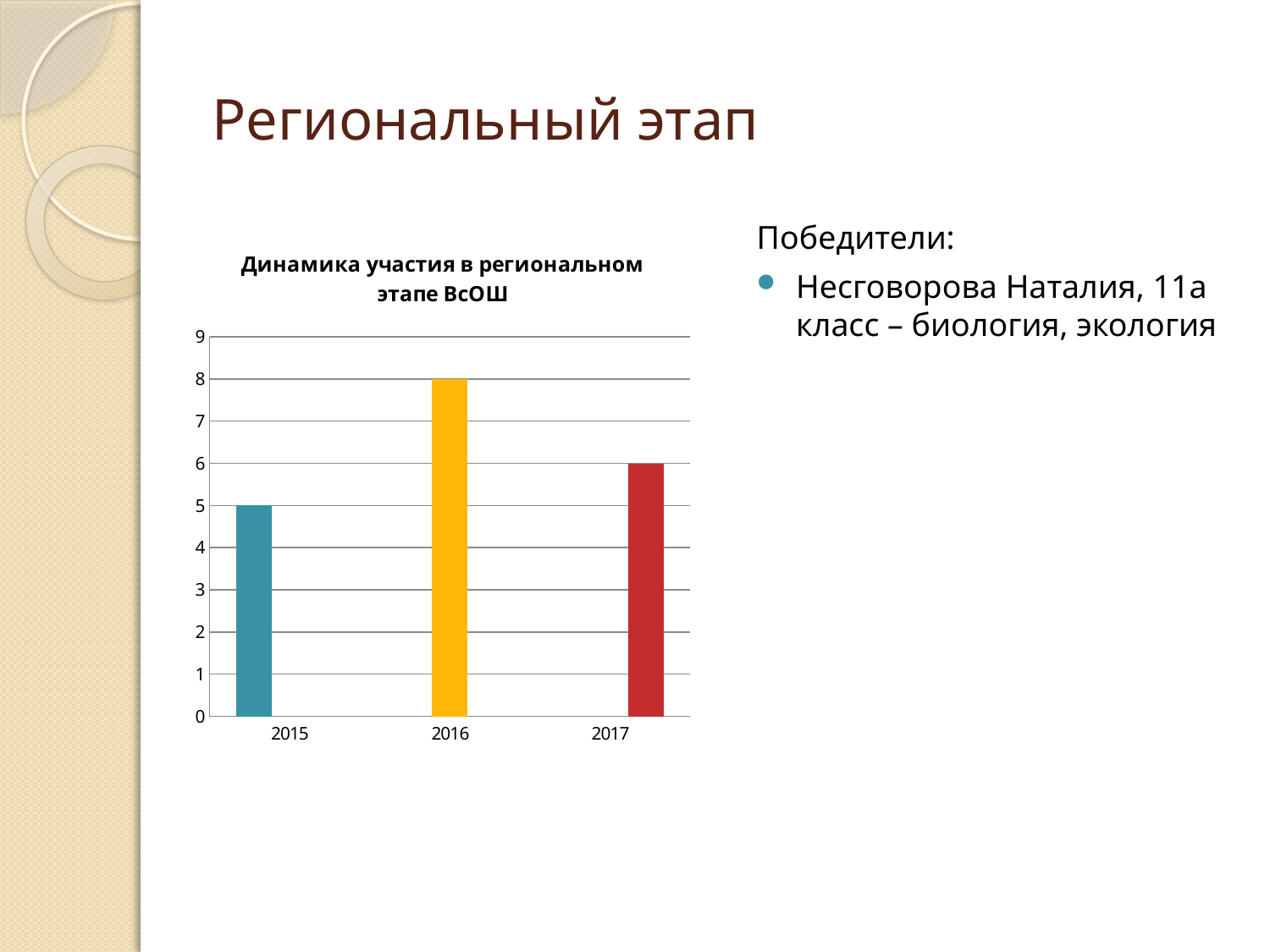
What is the value for 2016 in the chart? 8 What is the title of the chart? Динамика участия в региональном этапе ВсОШ What is the difference between the values for 2016 and 2017? 2 How many years are shown on the x axis of the chart? 3 Which year has the lowest value in the chart? 2015 What is the difference between the values for 2016 and 2015? 3 What is the value for 2017 in the chart? 6 What is the value for 2015 in the chart? 5 Is the value for 2016 greater or less than 7? greater Which year has the highest value in the chart? 2016 Which is larger, the value for 2017 or the value for 2015? 2017 What kind of chart is shown on the slide? bar chart